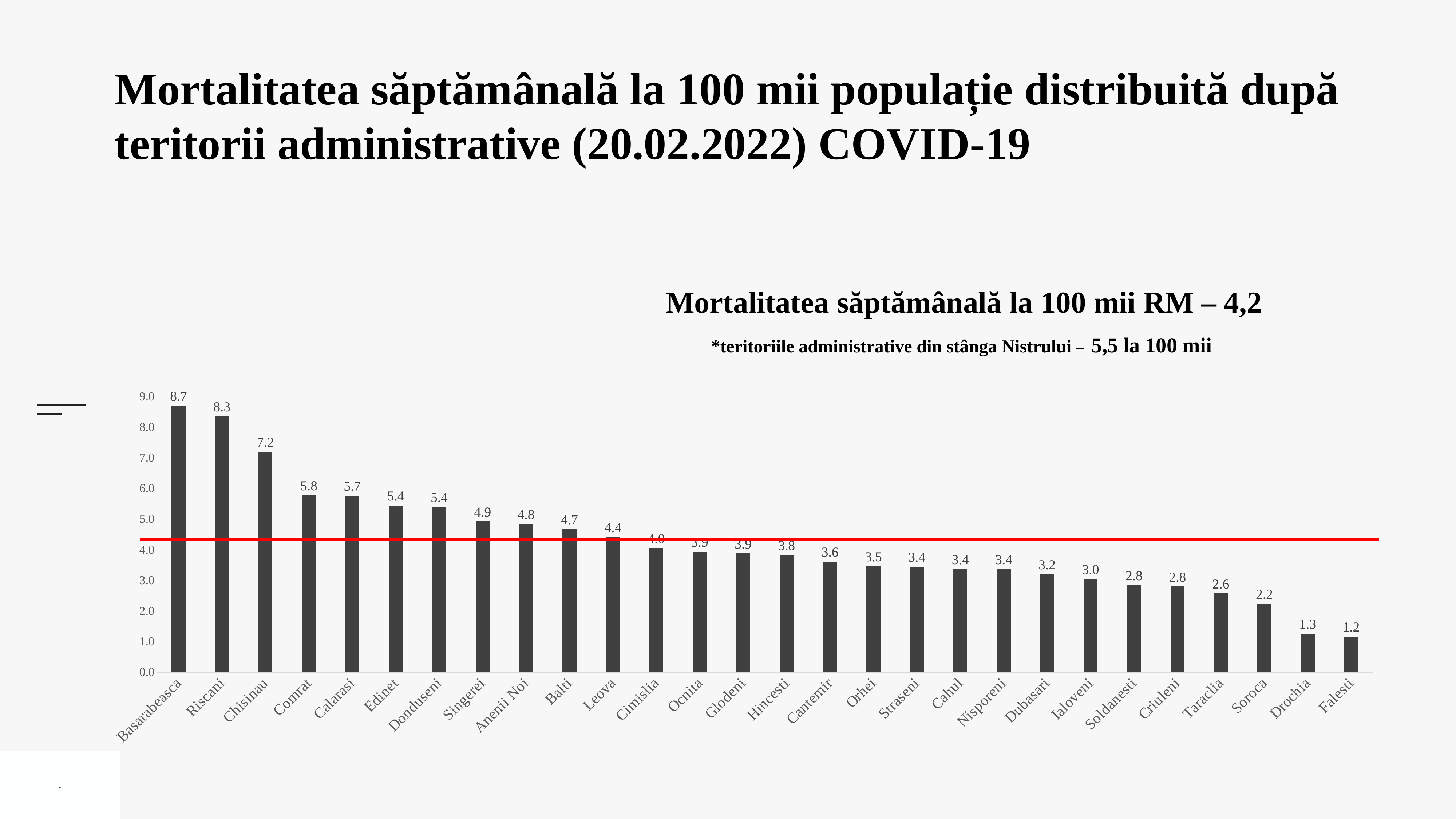
What is the value for Basarabeasca? 8.7 What is the difference between the values for Riscani and Comrat? 2.5 Is the value for Drochia greater or less than 2.0? less How many territories are shown on the x axis? 28 What is the value for Soroca? 2.2 Which is larger, the value for Balti or the value for Hincesti? Balti Which territory has the lowest value? Falesti What value does the text above the chart give for the weekly mortality per 100 thousand in RM? 4,2 Do the values rise or fall from left to right along the x axis? fall Which territory has the highest value? Basarabeasca What is the value for Chisinau? 7.2 What kind of chart is shown on the slide? bar chart